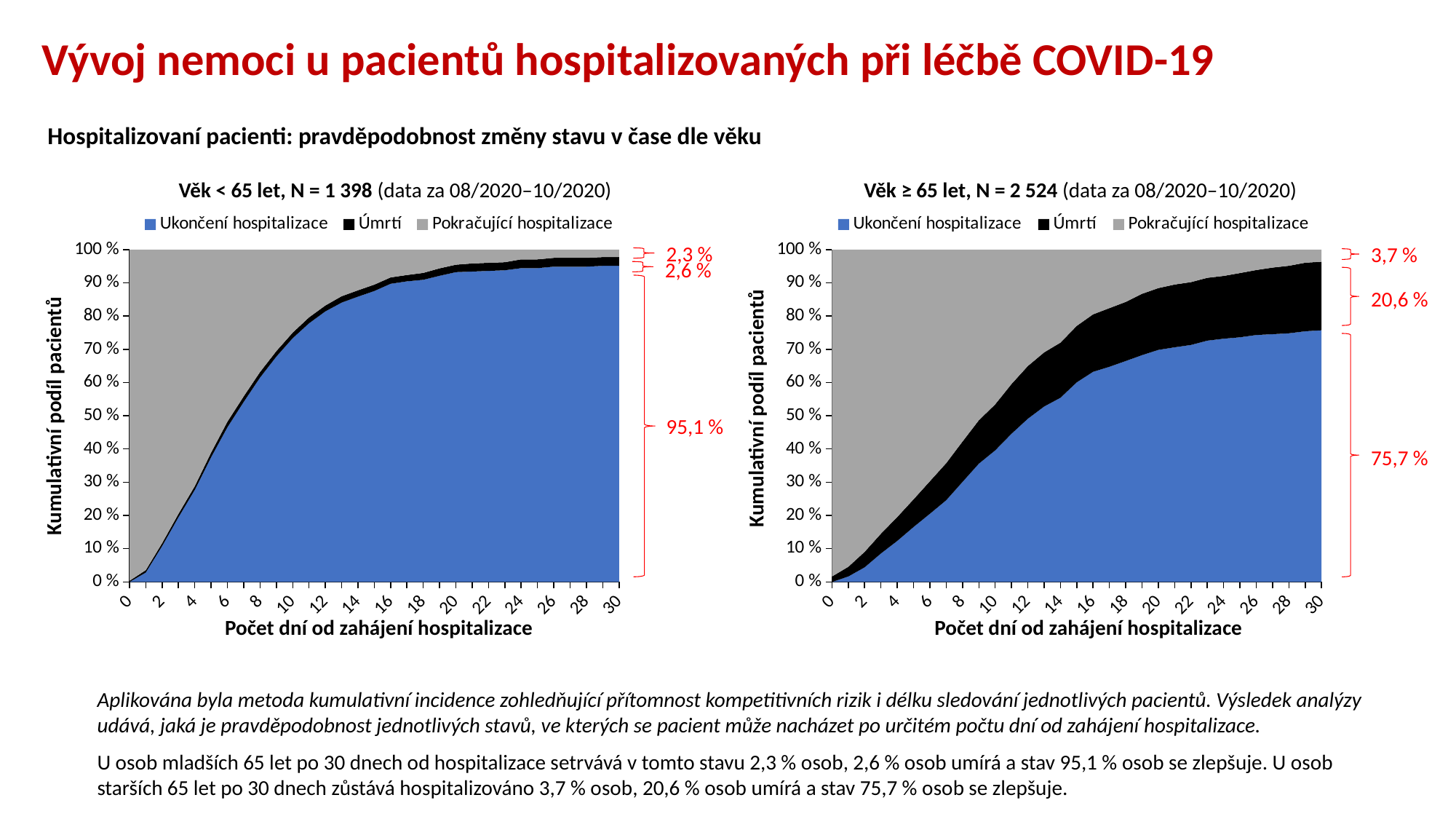
Which chart shows the larger Úmrtí share at day 30, the left (Věk < 65 let) or the right (Věk ≥ 65 let)? Right (Věk ≥ 65 let) In the left chart (Věk < 65 let), which of the three states has the largest share at day 30? Ukončení hospitalizace In the left chart (Věk < 65 let), is the Ukončení hospitalizace share at day 10 greater or less than 60 %? greater What is the difference between the Úmrtí share at day 30 in the right chart (20,6 %) and in the left chart (2,6 %)? 18,0 % In the right chart (Věk ≥ 65 let), which of the three states has the smallest share at day 30? Pokračující hospitalizace In the right chart (Věk ≥ 65 let), what share of patients is labelled for Ukončení hospitalizace at day 30? 75,7 % How many series does the legend of the left chart list? 3 What kind of chart is the right chart (Věk ≥ 65 let)? Stacked area chart In the left chart (Věk < 65 let), what share of patients is labelled for Pokračující hospitalizace at day 30? 2,3 % What is the difference between the Ukončení hospitalizace share at day 30 in the left chart (95,1 %) and in the right chart (75,7 %)? 19,4 % In the right chart (Věk ≥ 65 let), what share of patients is labelled for Úmrtí at day 30? 20,6 % In the left chart (Věk < 65 let), what share of patients is labelled for Ukončení hospitalizace at day 30? 95,1 %